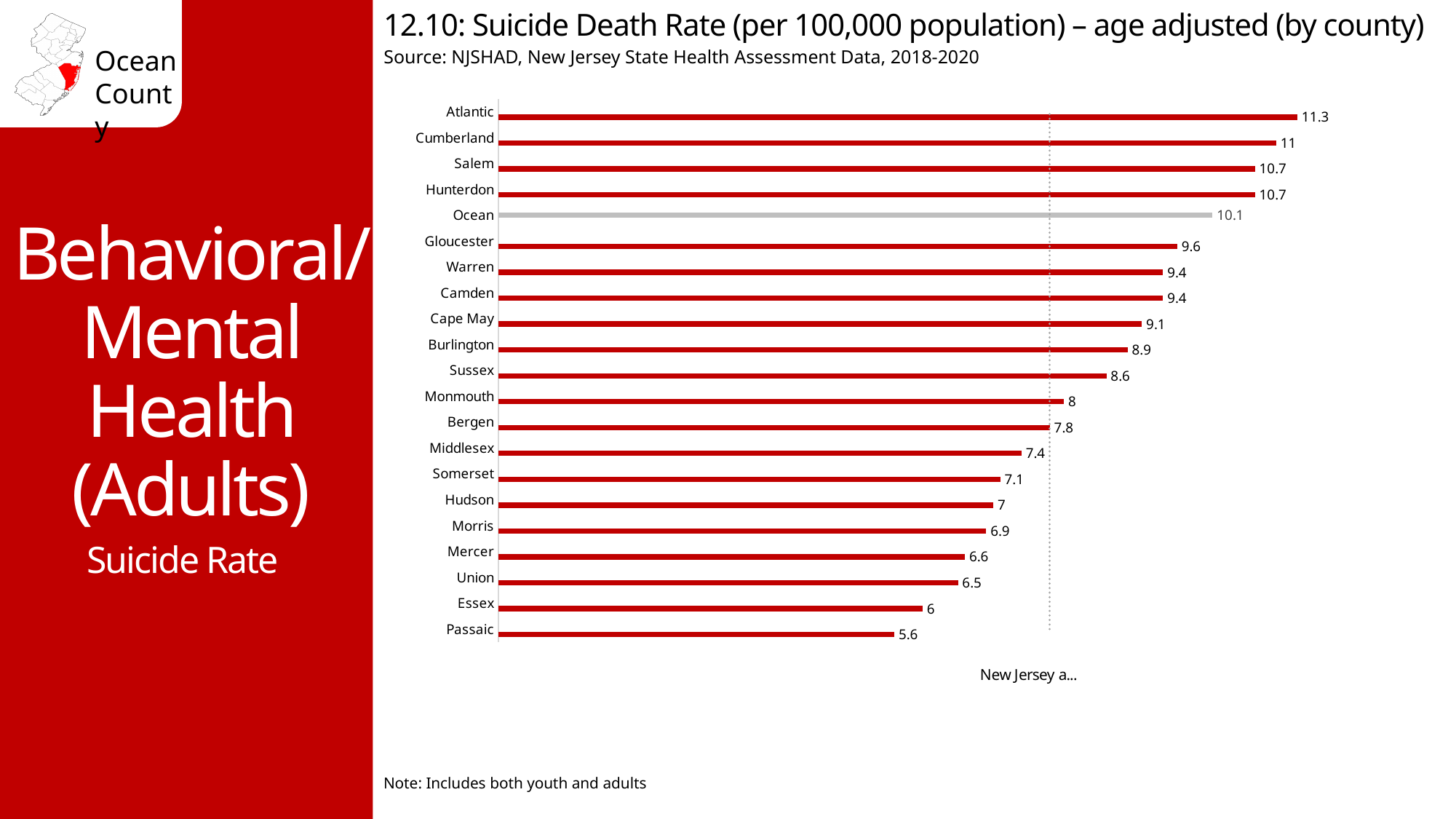
What is the suicide death rate for Passaic County? 5.6 Which county's bar is shown in gray instead of red? Ocean What is the difference between the suicide death rates of Atlantic and Passaic counties? 5.7 Do the values rise or fall going from the top bar to the bottom bar? Fall Which county has a higher suicide death rate, Gloucester or Bergen? Gloucester Which county has the highest suicide death rate? Atlantic How many counties are shown in the chart? 21 What is the suicide death rate for Ocean County? 10.1 What is the difference between the suicide death rates of Ocean and Monmouth counties? 2.1 What is the suicide death rate for Atlantic County? 11.3 What type of chart is used on this slide? Bar chart Which county has the lowest suicide death rate? Passaic